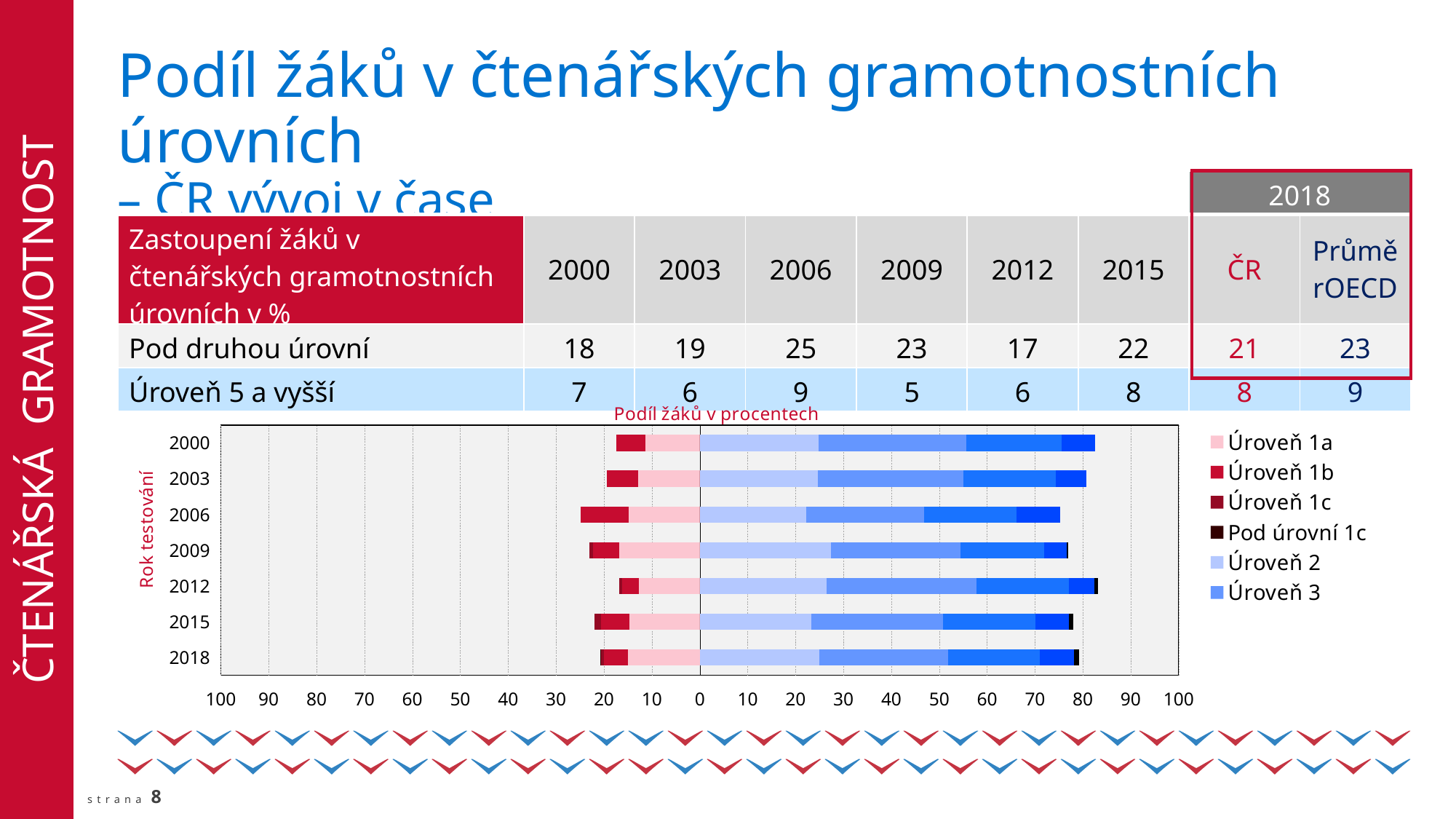
Is the bar extending to the left of zero for 2012 greater or less than 20? less Is the bar extending to the right of zero for 2006 greater or less than 80? less Which year has the longest bar extending to the left of zero (below level 2)? 2006 Is the bar extending to the left of zero for 2006 greater or less than 20? greater What is the first entry in the chart's legend? Úroveň 1a What is the title of the chart's horizontal axis? Podíl žáků v procentech Which year has a longer bar to the right of zero, 2000 or 2006? 2000 How many series does the chart's legend list? 6 How many years (categories) are plotted on the chart's vertical axis? 7 Which year has a longer bar to the left of zero, 2006 or 2012? 2006 What kind of chart is shown on the slide? bar chart